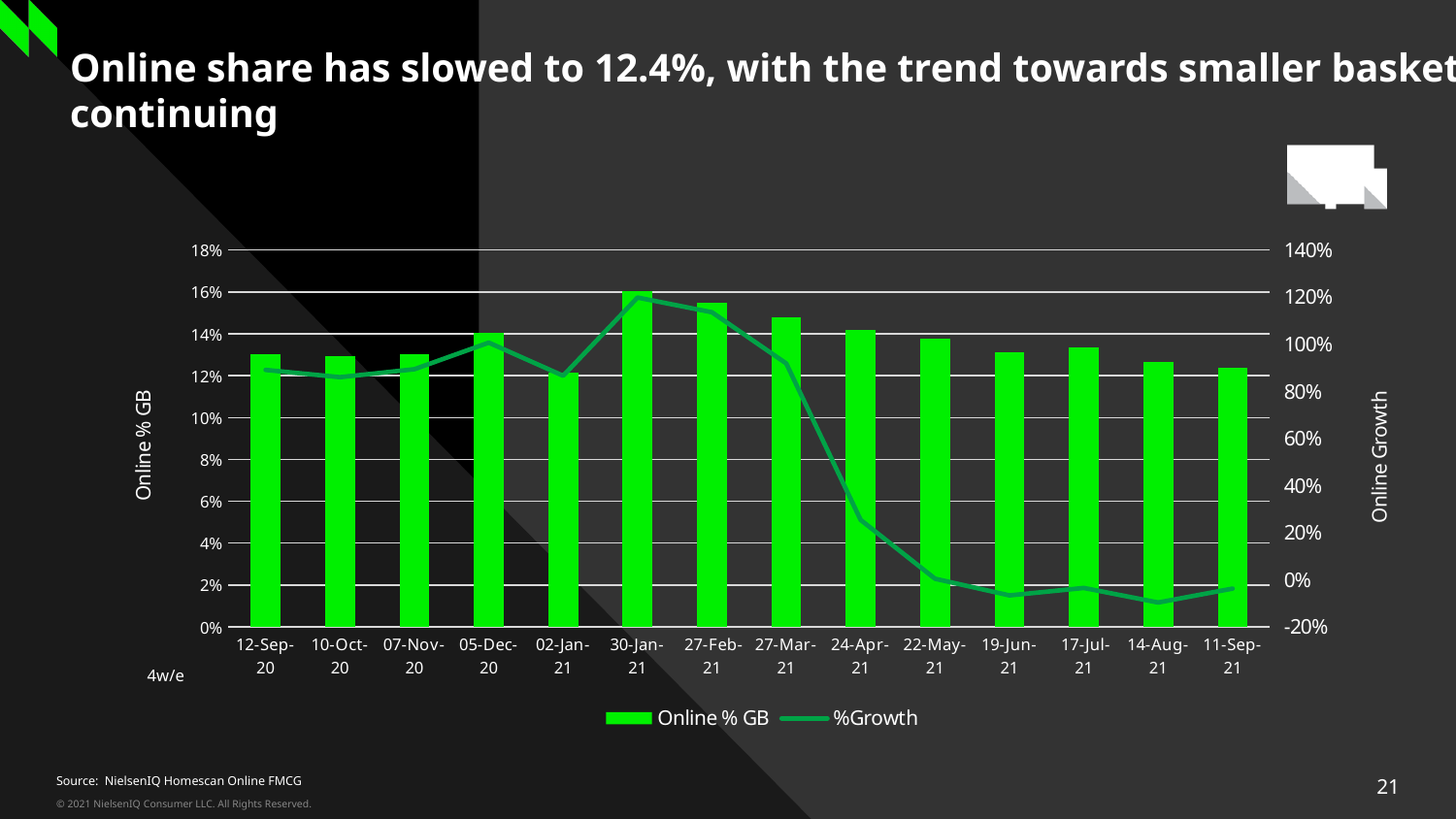
Is the %Growth value for 30-Jan-21 greater or less than 100%? greater What is the title of the left vertical axis? Online % GB Which has the larger Online % GB value, 30-Jan-21 or 11-Sep-21? 30-Jan-21 Does the %Growth line rise or fall from 30-Jan-21 to 14-Aug-21? fall What kind of chart is shown on the slide? Combined bar and line chart Is the %Growth value for 24-Apr-21 greater or less than 40%? less How many time periods are shown on the x axis of the chart? 14 How many series does the chart legend list? 2 Is the %Growth value for 14-Aug-21 greater or less than 0%? less Which period has the highest Online % GB bar? 30-Jan-21